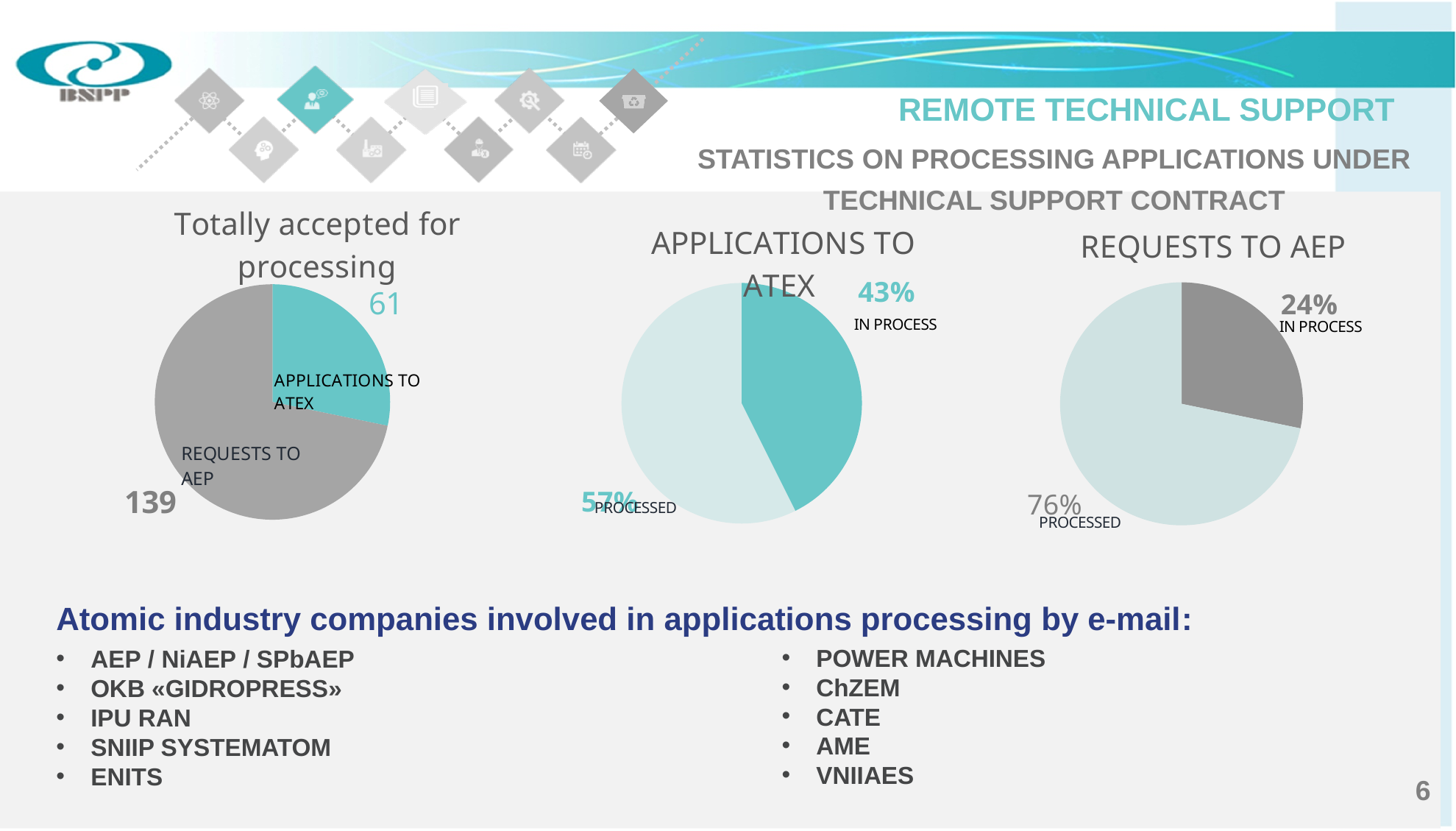
In the 'Totally accepted for processing' chart, what is the difference between Requests to AEP and Applications to ATEX? 78 In the 'Requests to AEP' chart, what share is in process? 24% How many slices does the 'Requests to AEP' pie chart have? 2 In the 'Requests to AEP' chart, what share is processed? 76% What kind of chart is the 'Applications to ATEX' chart? Pie chart In the 'Totally accepted for processing' chart, what is the value for Requests to AEP? 139 In the 'Totally accepted for processing' chart, which category has the larger value? Requests to AEP Which chart has the larger processed share, 'Applications to ATEX' or 'Requests to AEP'? Requests to AEP In the 'Applications to ATEX' chart, what share is processed? 57% In the 'Applications to ATEX' chart, what share is in process? 43% In the 'Totally accepted for processing' chart, what is the total of the two slices? 200 In the 'Totally accepted for processing' chart, what is the value for Applications to ATEX? 61